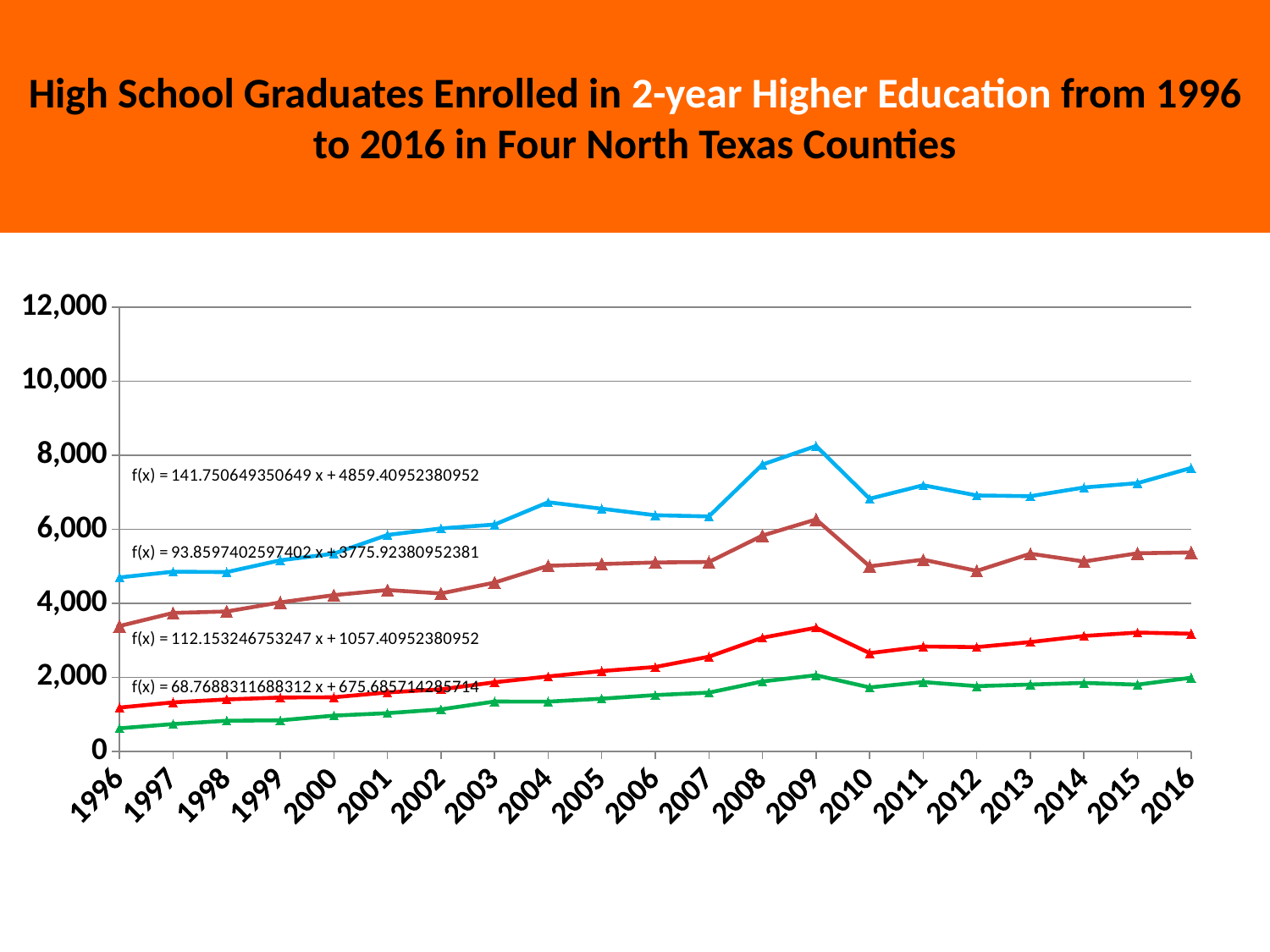
In 2016, which is larger: the value of the blue line or the value of the green line? the blue line How many years are plotted along the x axis of the chart? 21 In which year does the blue line reach its highest value? 2009 Is the value of the red line in 2009 greater or less than 4,000? less Does the blue line rise or fall from 1996 to 2009? rise Is the value of the brown line in 2009 greater or less than 4,000? greater What kind of chart is shown on the slide? line chart What is the highest value shown on the y axis of the chart? 12,000 Which line is the highest across the whole chart? the blue line Is the value of the green line in 1996 greater or less than 2,000? less Which line is the lowest across the whole chart? the green line